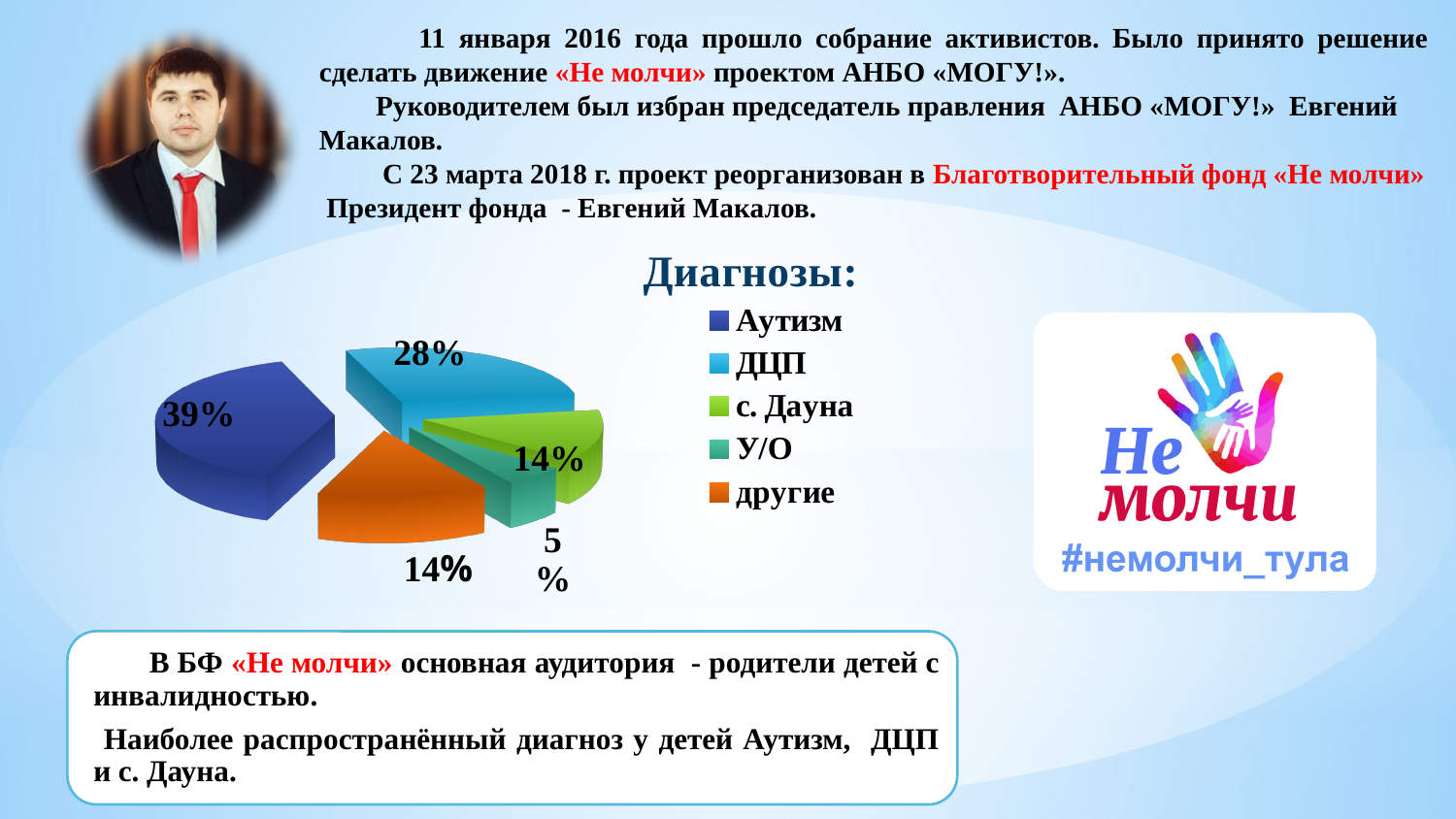
What type of chart is used to show the diagnoses? Pie chart Which diagnosis has the smallest slice in the pie chart? У/О Which diagnosis has the largest slice in the pie chart? Аутизм What is the difference in percentage points between Аутизм and ДЦП? 11 What percentage is shown for с. Дауна? 14% What percentage is shown for ДЦП in the pie chart? 28% What percentage is shown for У/О? 5% How many categories does the pie chart show? 5 Which is larger, the share for ДЦП or the share for с. Дауна? ДЦП What is the title of the chart? Диагнозы: What share of the pie chart does Аутизм represent? 39% What percentage is shown for the category другие? 14%